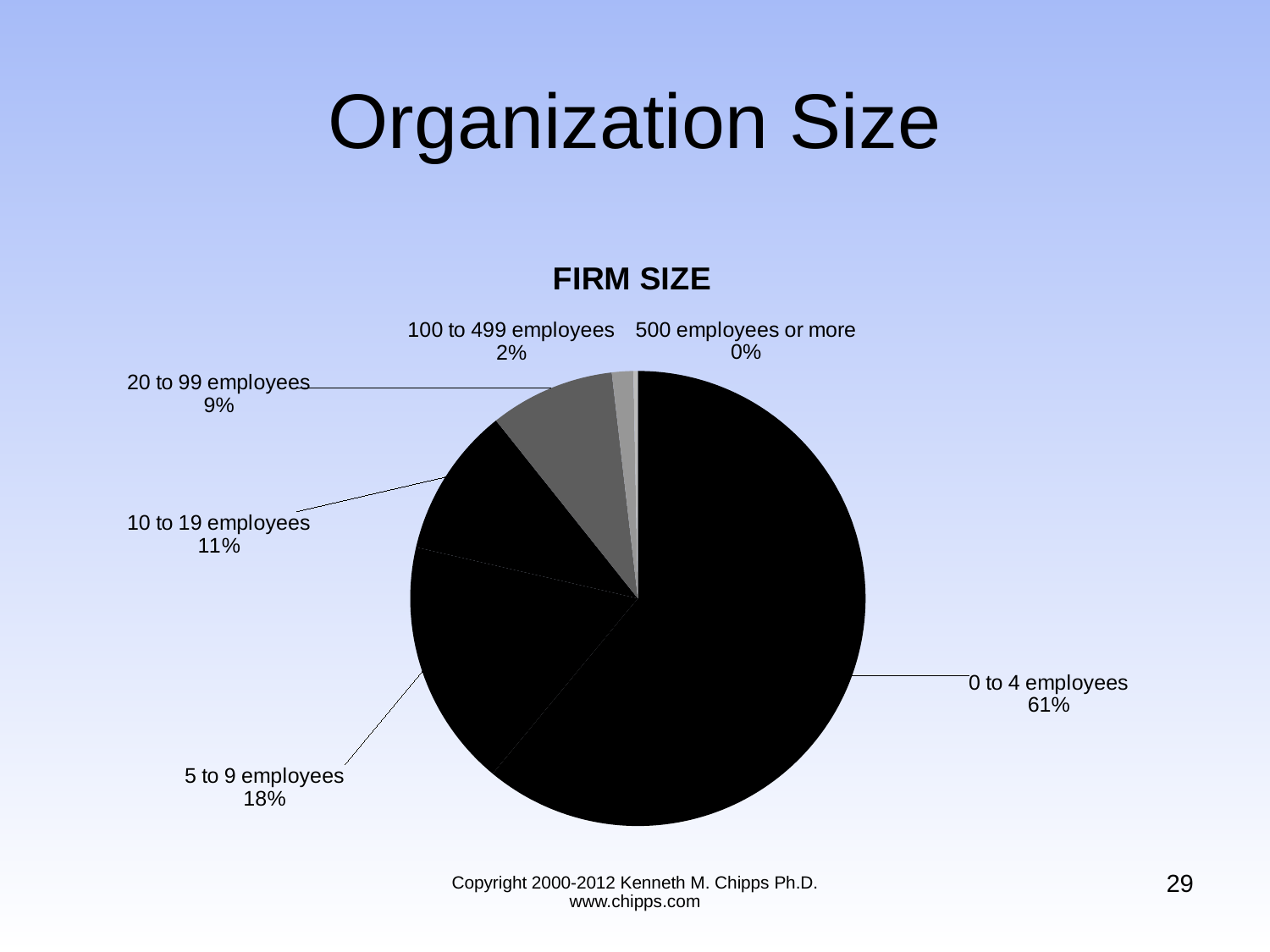
What is the title of the chart? FIRM SIZE Which firm size category has the smallest share? 500 employees or more What share of the pie is for 0 to 4 employees? 61% How many firm size categories are shown in the pie chart? 6 What share of the pie is for 500 employees or more? 0% What is the difference in share between 5 to 9 employees and 10 to 19 employees? 7% What share of the pie is for 5 to 9 employees? 18% Which firm size category has the largest share? 0 to 4 employees What type of chart is shown on the slide? pie chart